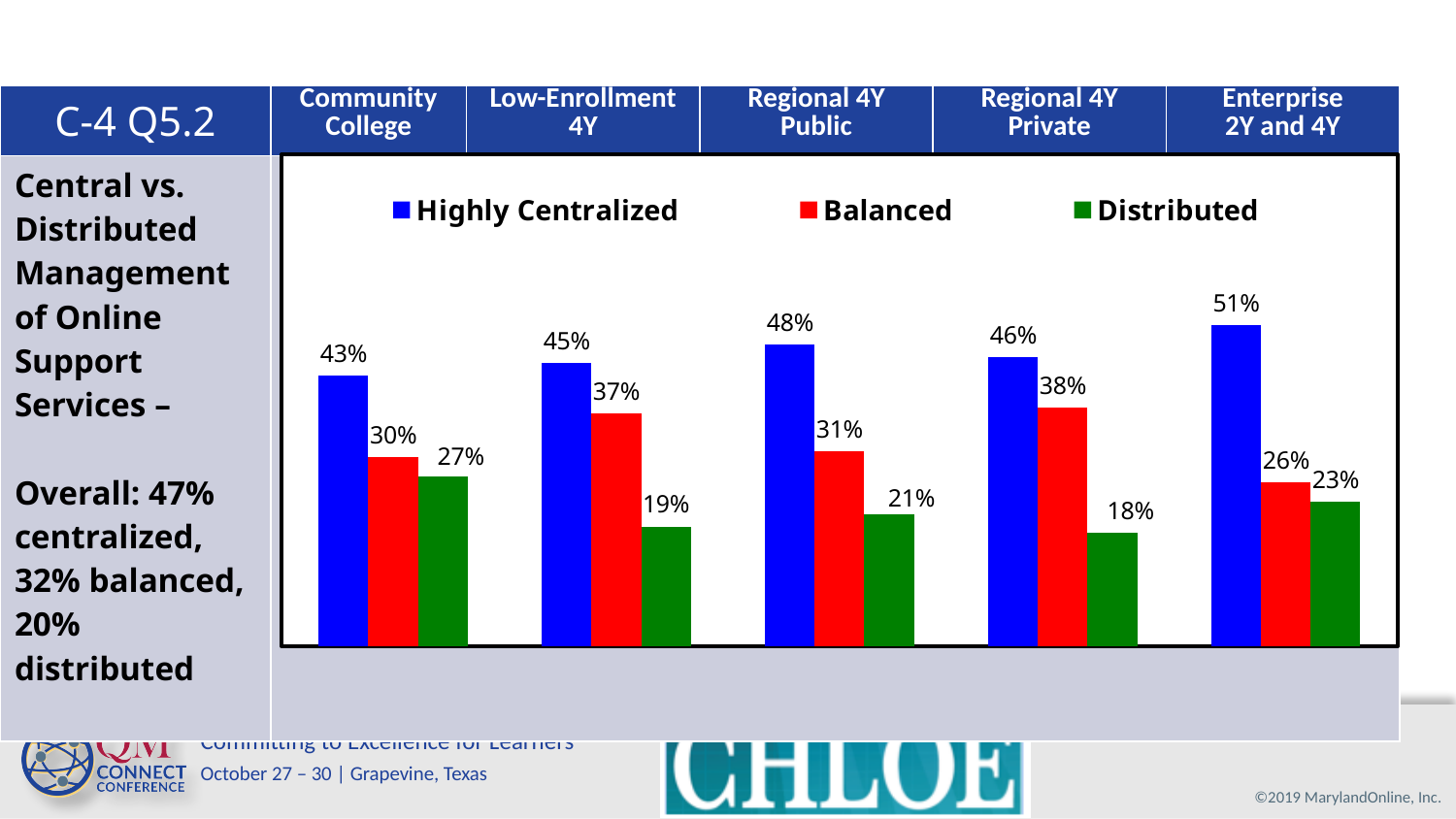
What is the Distributed value for Low-Enrollment 4Y? 19% What is the Balanced value for Regional 4Y Private? 38% Which is larger for Enterprise 2Y and 4Y: the Balanced value or the Distributed value? Balanced How many institution types are shown on the chart? 5 How many series does the legend list? 3 What is the Highly Centralized value for Community College? 43% What is the difference between the Highly Centralized and Balanced values for Regional 4Y Public? 17% Which institution type has the highest Highly Centralized value? Enterprise 2Y and 4Y What is the Distributed value for Community College? 27% Which institution type has the lowest Distributed value? Regional 4Y Private What kind of chart is shown? Bar chart Which series is shown in red? Balanced